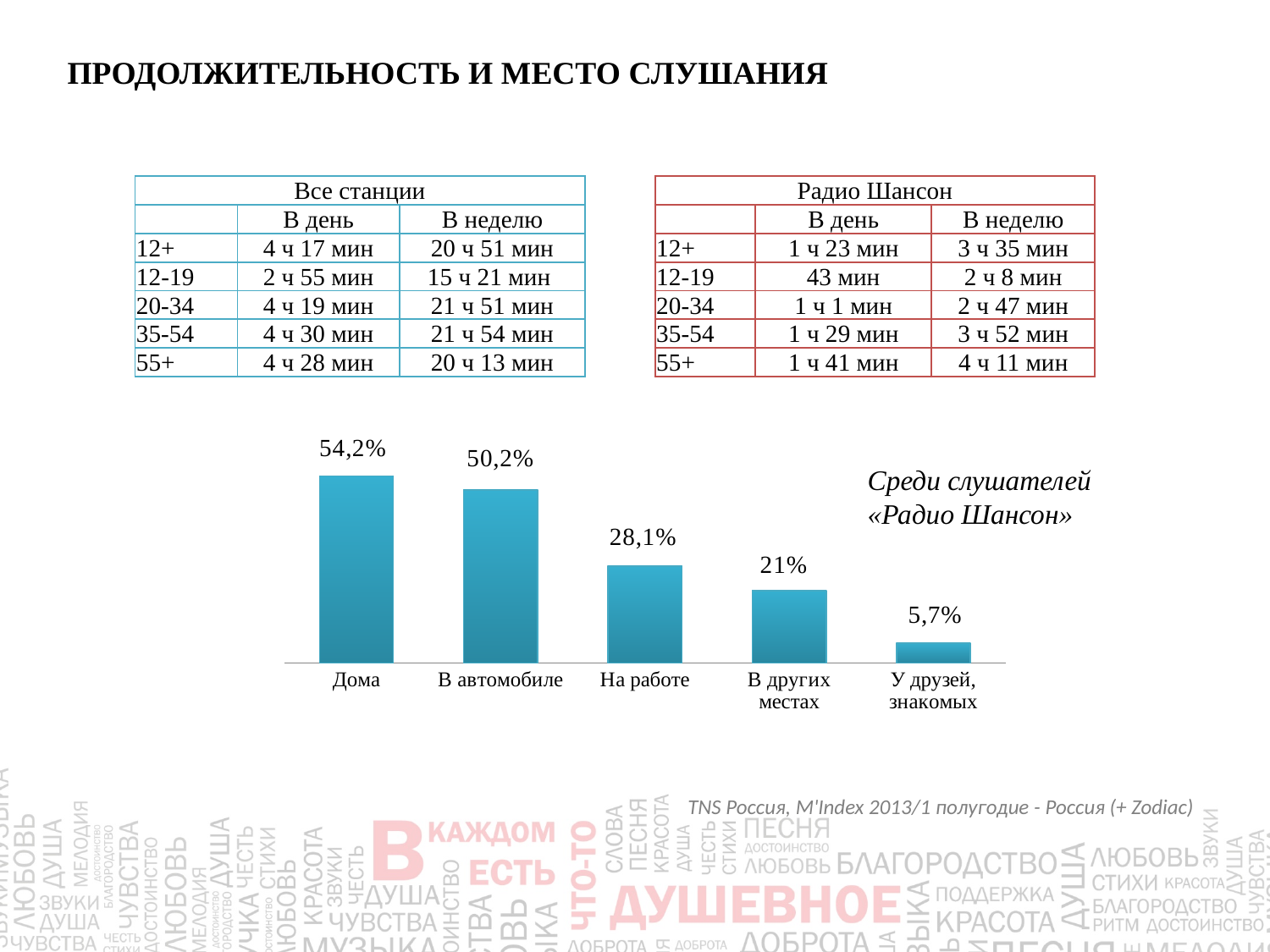
What is the value for В автомобиле in the bar chart? 50,2% Which category has the lowest value in the bar chart? У друзей, знакомых Which category has the highest value in the bar chart? Дома What is the value for На работе in the bar chart? 28,1% What is the value for Дома in the bar chart? 54,2% What is the value for У друзей, знакомых in the bar chart? 5,7% What is the value for В других местах in the bar chart? 21% What is the difference between the values for На работе and В других местах in the bar chart? 7,1 percentage points How many categories are shown in the bar chart? 5 Which is larger in the bar chart: На работе or В других местах? На работе What type of chart is shown on the slide? Bar chart What is the difference between the values for Дома and В автомобиле in the bar chart? 4 percentage points